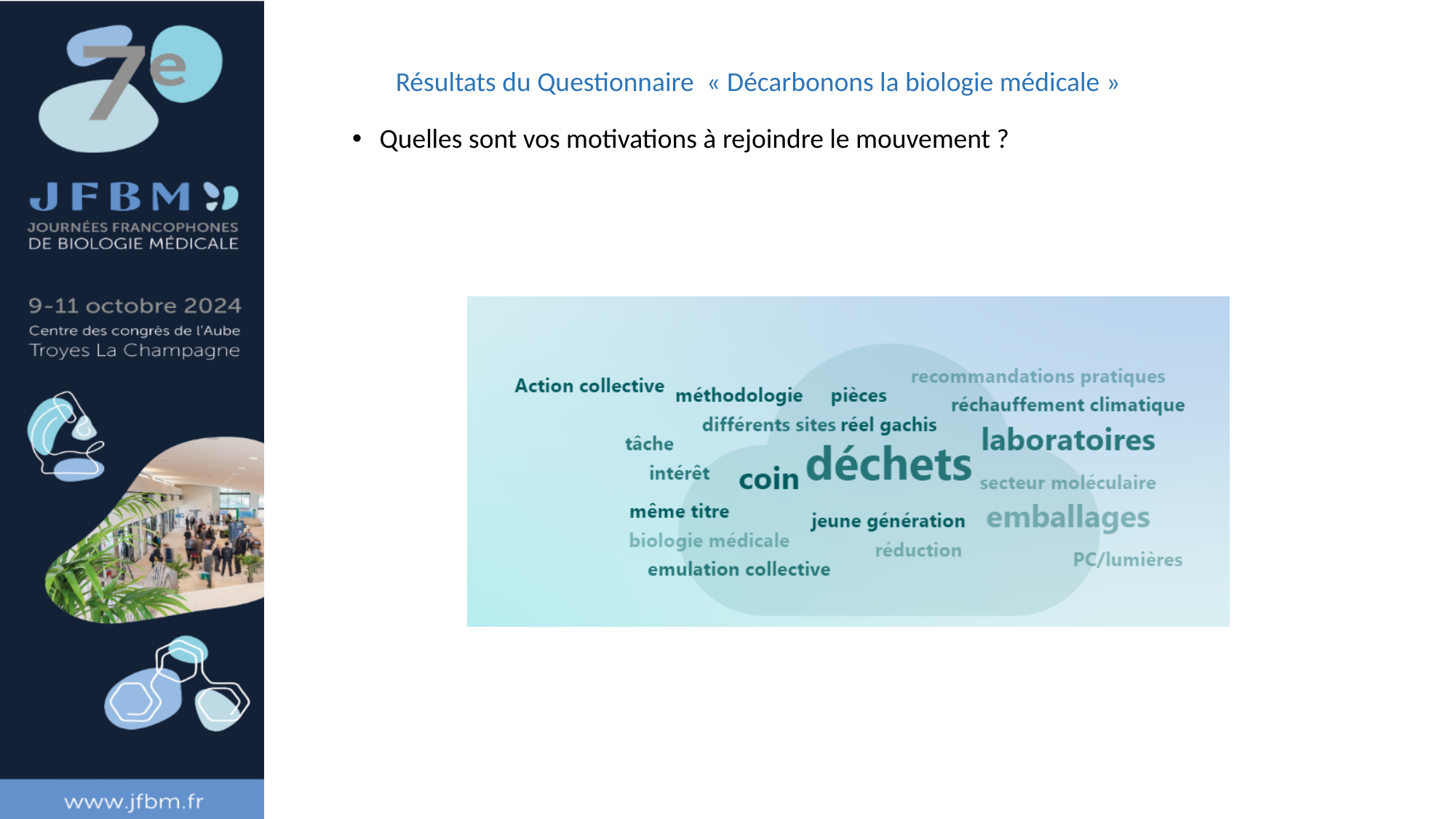
Which question does the word cloud on the slide answer? Quelles sont vos motivations à rejoindre le mouvement ? Which word appears largest in the word cloud? déchets Which is displayed larger in the word cloud, "laboratoires" or "réduction"? laboratoires What kind of chart is shown on the slide? word cloud